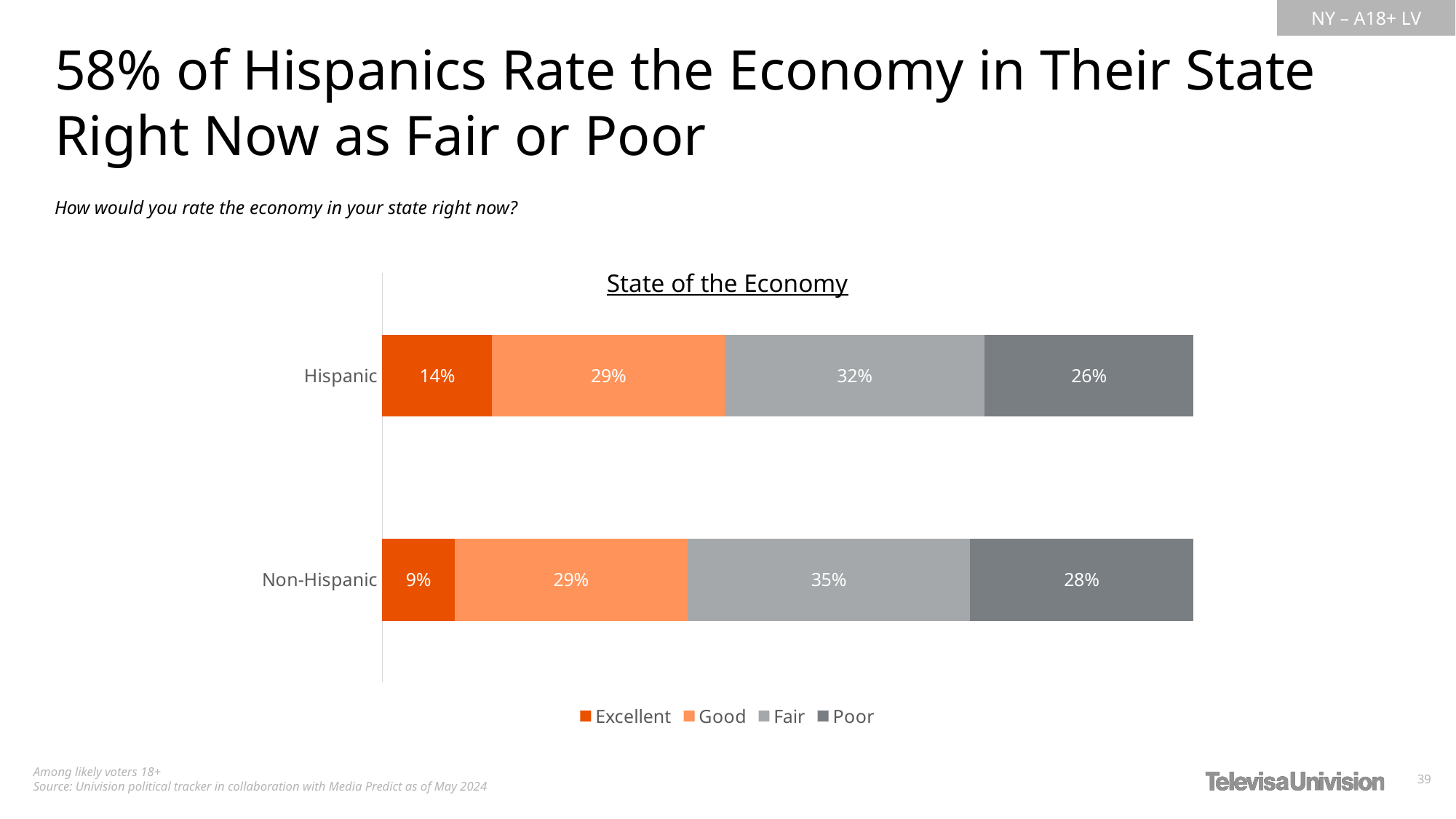
What type of chart is shown on the slide? Stacked bar chart What percentage of Hispanic respondents rate the economy as Poor? 26% What is the combined Fair and Poor share for Hispanic respondents? 58% How many groups (bars) are shown in the chart? 2 What percentage of Non-Hispanic respondents rate the economy in their state as Fair? 35% Which rating category has the largest share among Hispanic respondents? Fair What percentage of Non-Hispanic respondents rate the economy as Excellent? 9% Which group has a larger Poor share, Hispanic or Non-Hispanic? Non-Hispanic What percentage of Hispanic respondents rate the economy in their state as Excellent? 14% Which rating category has the smallest share among Non-Hispanic respondents? Excellent How many series does the legend list? 4 What is the difference between the Excellent share for Hispanic and Non-Hispanic respondents? 5 percentage points